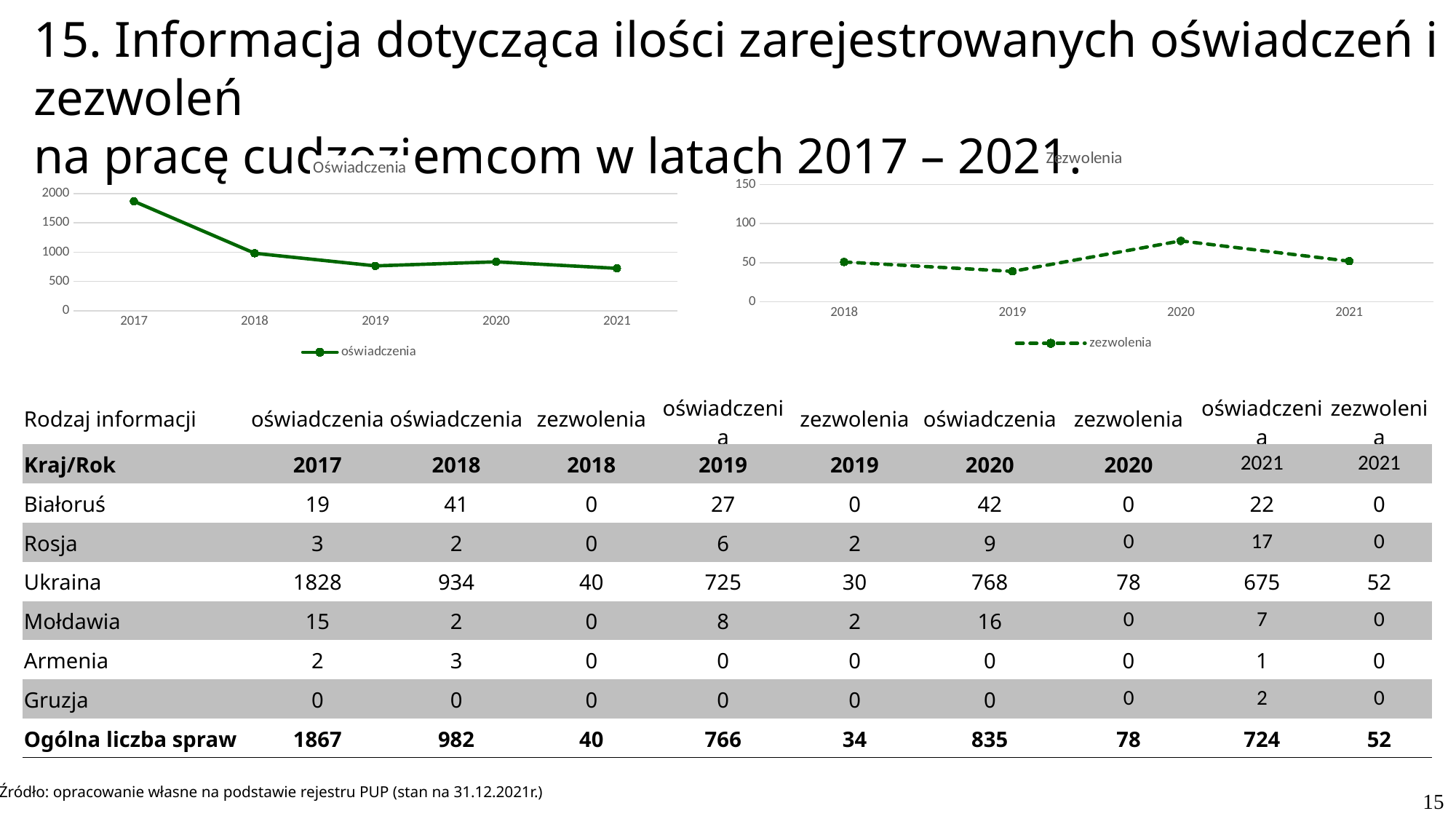
How many series does the legend of the Zezwolenia chart list? 1 In the Zezwolenia chart, is the value for 2019 greater or less than 100? less In the Oświadczenia chart, is the value for 2017 greater or less than 1500? greater In the Zezwolenia chart, which year has the highest value? 2020 How many years are plotted in the Zezwolenia chart? 4 In the Zezwolenia chart, is the value for 2020 greater or less than 50? greater In the Oświadczenia chart, does the value rise or fall from 2017 to 2018? fall How many years are plotted in the Oświadczenia chart? 5 In the Oświadczenia chart, is the value for 2017 larger or smaller than the value for 2018? larger What kind of chart is the Oświadczenia chart on the left? line chart In the Oświadczenia chart, which year has the highest value? 2017